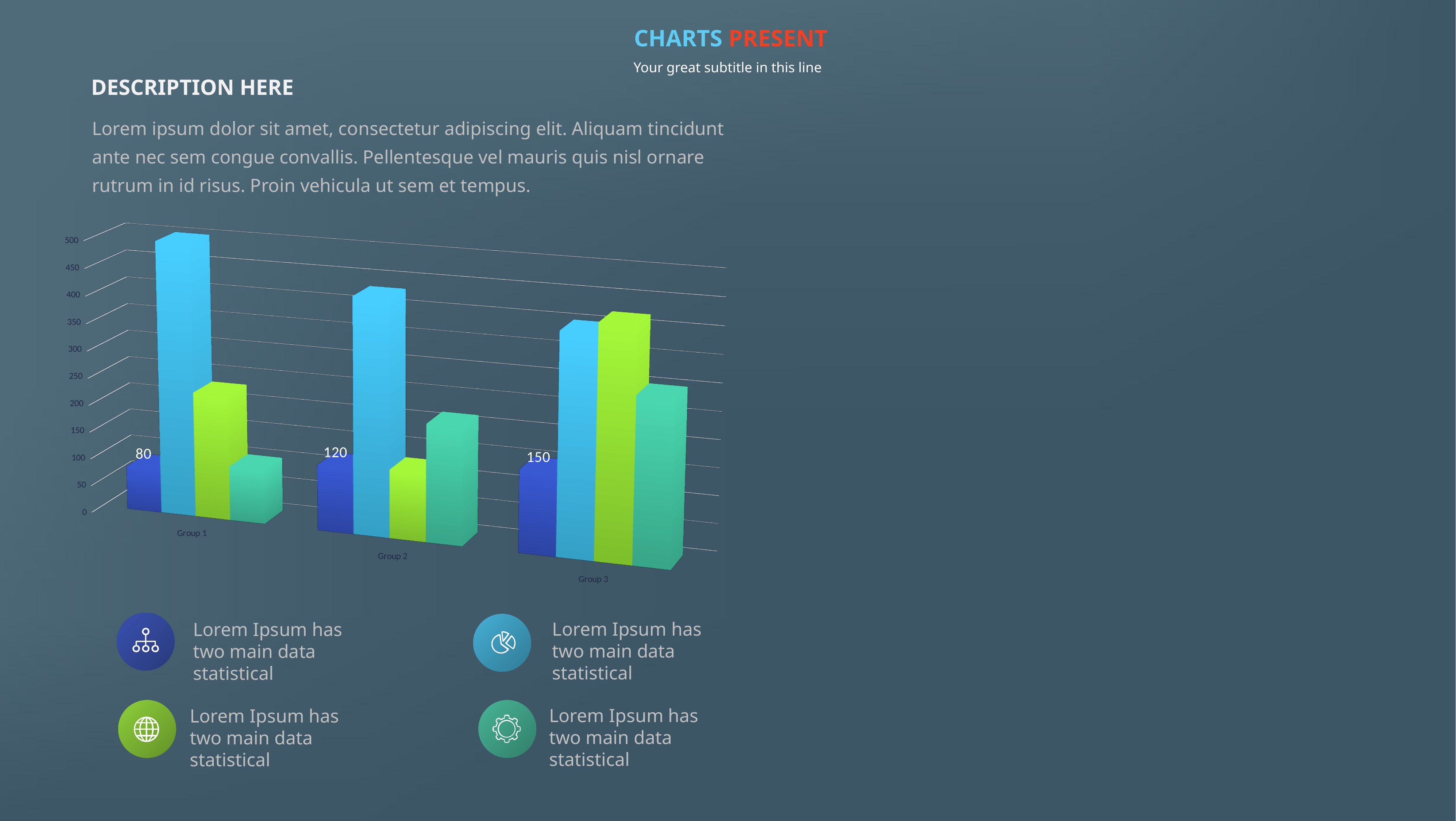
Is the value of the light blue bar for Group 1 greater or less than 450? greater What is the labelled value of the dark blue bar for Group 2? 120 Which is larger: the labelled dark blue value for Group 2 or for Group 3? Group 3 What is the difference between the labelled dark blue values for Group 2 and Group 1? 40 What is the labelled value of the dark blue bar for Group 1? 80 How many groups are shown on the x axis of the chart? 3 What is the labelled value of the dark blue bar for Group 3? 150 What kind of chart is shown on the slide? bar chart Do the labelled dark blue values rise or fall from Group 1 to Group 3? rise Among the labelled dark blue bars, which group has the highest value? Group 3 What is the difference between the labelled dark blue values for Group 3 and Group 1? 70 Among the labelled dark blue bars, which group has the lowest value? Group 1